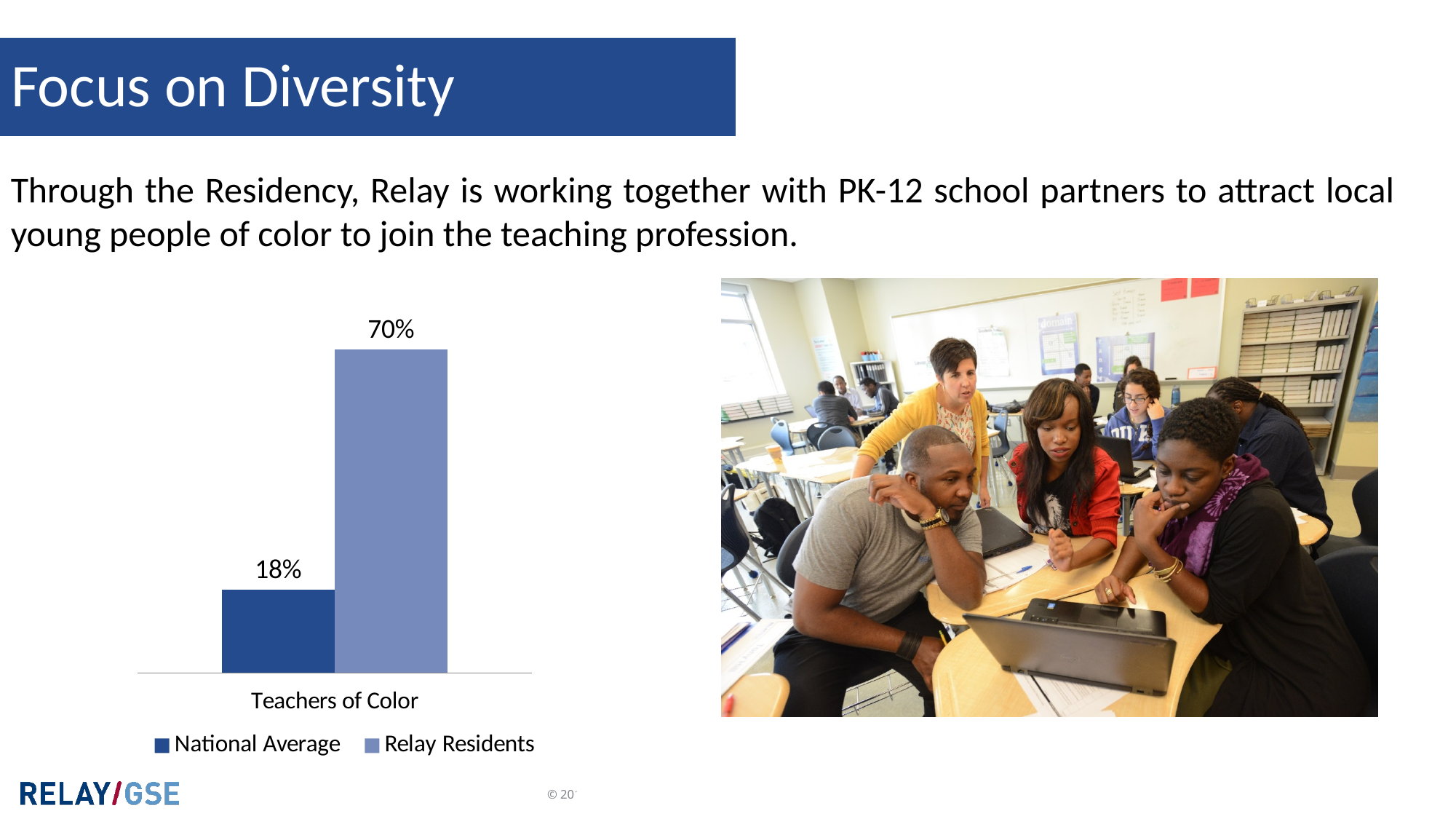
Which series has the lower value for Teachers of Color? National Average What is the value for Relay Residents in the Teachers of Color chart? 70% What is the category label on the x axis of the chart? Teachers of Color What is the value for National Average in the Teachers of Color chart? 18% What is the difference between the Relay Residents value and the National Average value for Teachers of Color? 52% How many categories are shown on the x axis of the chart? 1 What kind of chart is shown on the slide? bar chart Is the Relay Residents value larger or smaller than the National Average value? larger How many series does the chart legend list? 2 Which series is shown in the lighter blue colour in the chart? Relay Residents Which series has the higher value for Teachers of Color? Relay Residents